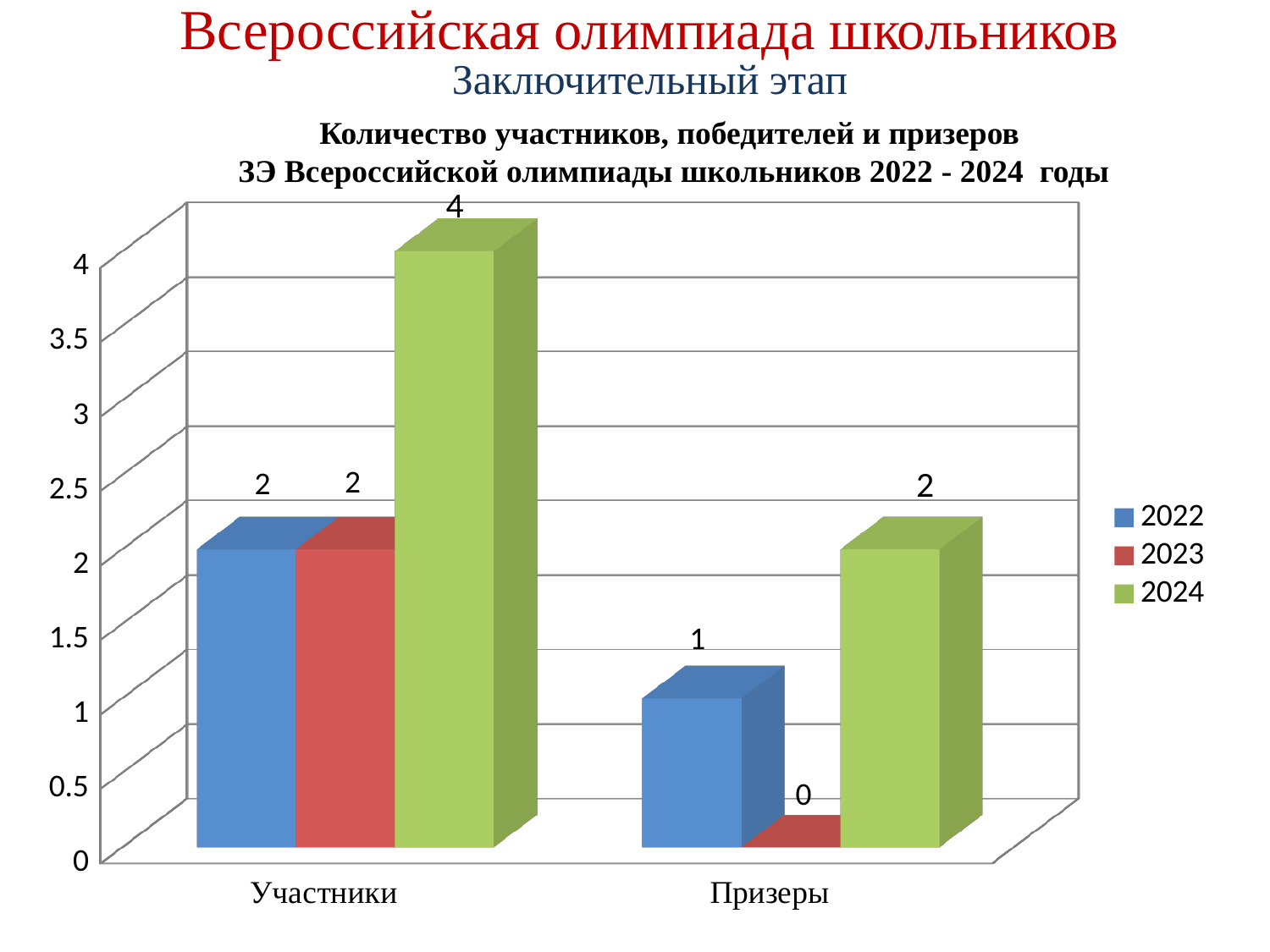
How many categories are shown on the x axis? 2 Which is larger: the 2024 value for Призеры or the 2022 value for Призеры? 2024 What kind of chart is shown on the slide? bar chart What is the value for 2023 in the Призеры category? 0 Which year has the lowest value in the Призеры category? 2023 What is the value for 2022 in the Призеры category? 1 What is the difference between the 2024 and 2022 values in the Участники category? 2 What is the value for 2023 in the Участники category? 2 Which year has the highest value in the Участники category? 2024 What is the value for 2024 in the Участники category? 4 Which colour represents the 2023 series in the legend? red How many series does the legend list? 3